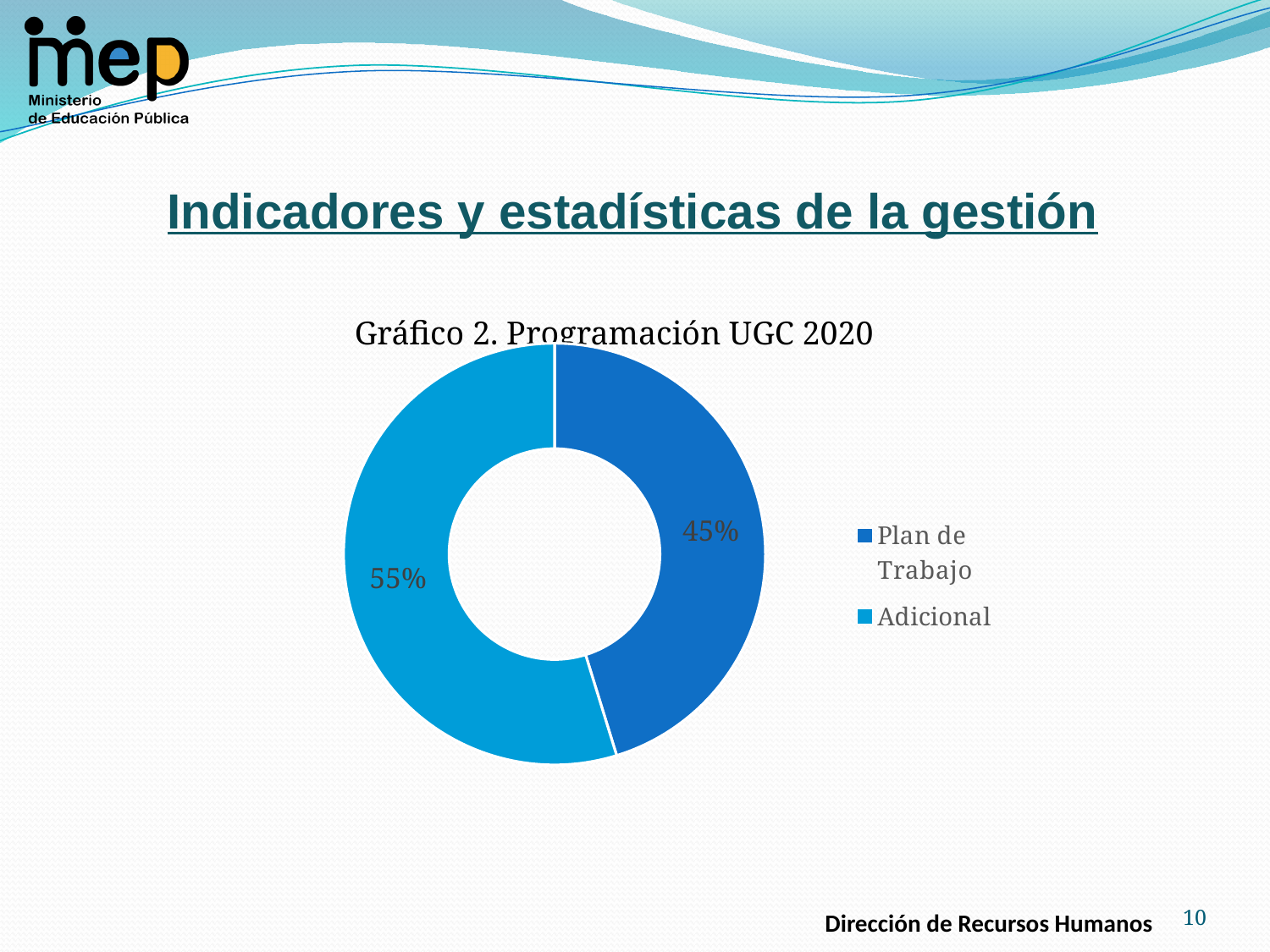
How many entries does the legend list? 2 Which category has the largest share? Adicional Which legend entry is shown in the lighter blue colour? Adicional What is the value for Plan de Trabajo? 45% What is the value for Adicional? 55% What kind of chart is shown? Doughnut (pie) chart How many categories does the chart show? 2 What is the difference between the Adicional and Plan de Trabajo shares? 10% What is the title of the chart? Gráfico 2. Programación UGC 2020 Which is larger, Plan de Trabajo or Adicional? Adicional What share of the chart does Adicional represent? 55% Which category has the smallest share? Plan de Trabajo